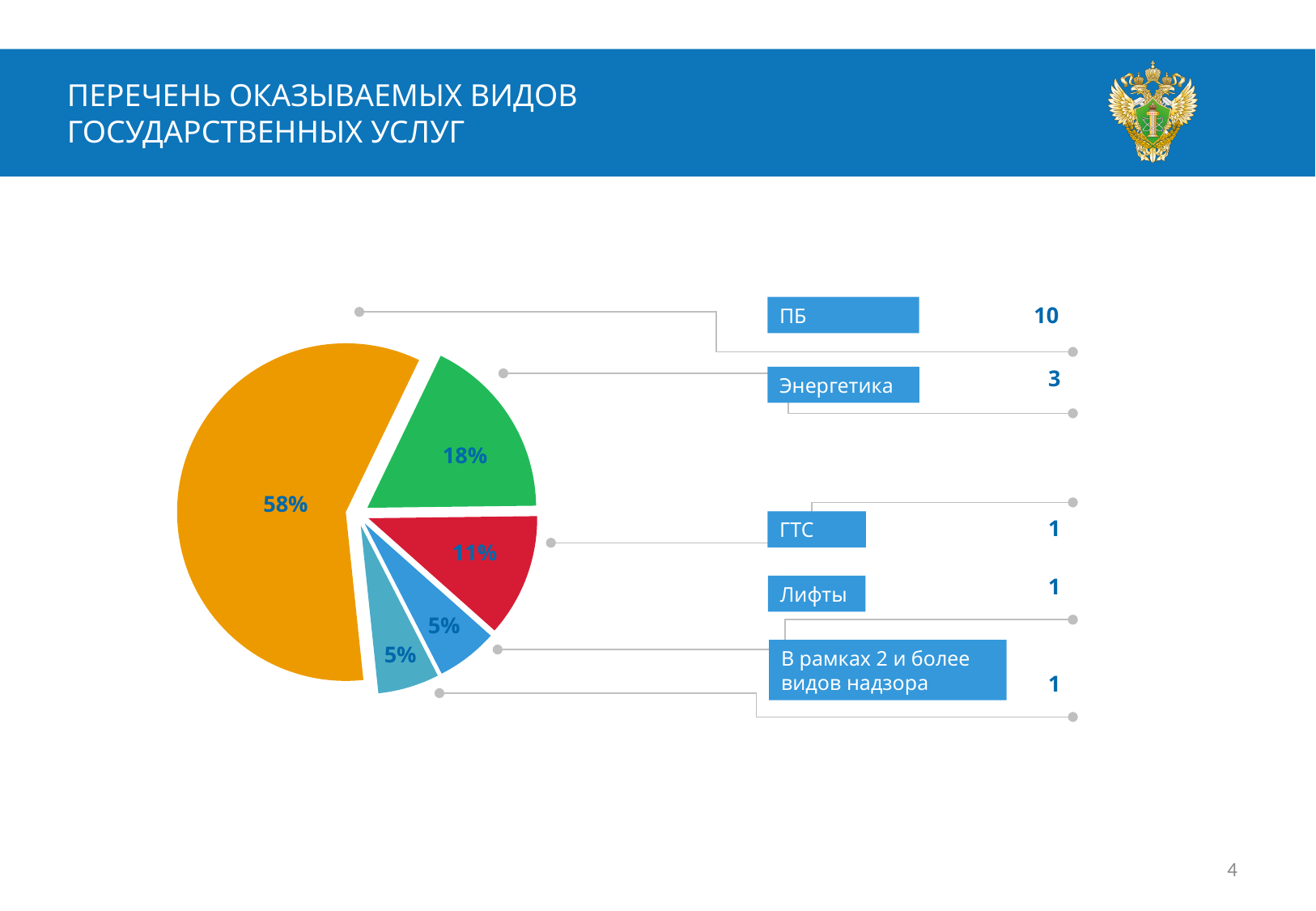
Which slice is larger, Энергетика or ГТС? Энергетика What number is shown next to the Энергетика label? 3 What percentage share is shown for the Энергетика slice? 18% How many slices does the pie chart have? 5 What percentage share is shown for the ПБ slice of the pie chart? 58% What kind of chart is shown on the slide? pie chart What is the difference in percentage points between the ПБ slice and the Энергетика slice? 40% What percentage share is shown for the ГТС slice? 11% What number is shown next to the ПБ label? 10 What percentage share is shown for the Лифты slice? 5% What is the title of the slide containing the pie chart? ПЕРЕЧЕНЬ ОКАЗЫВАЕМЫХ ВИДОВ ГОСУДАРСТВЕННЫХ УСЛУГ Which category has the largest slice of the pie chart? ПБ